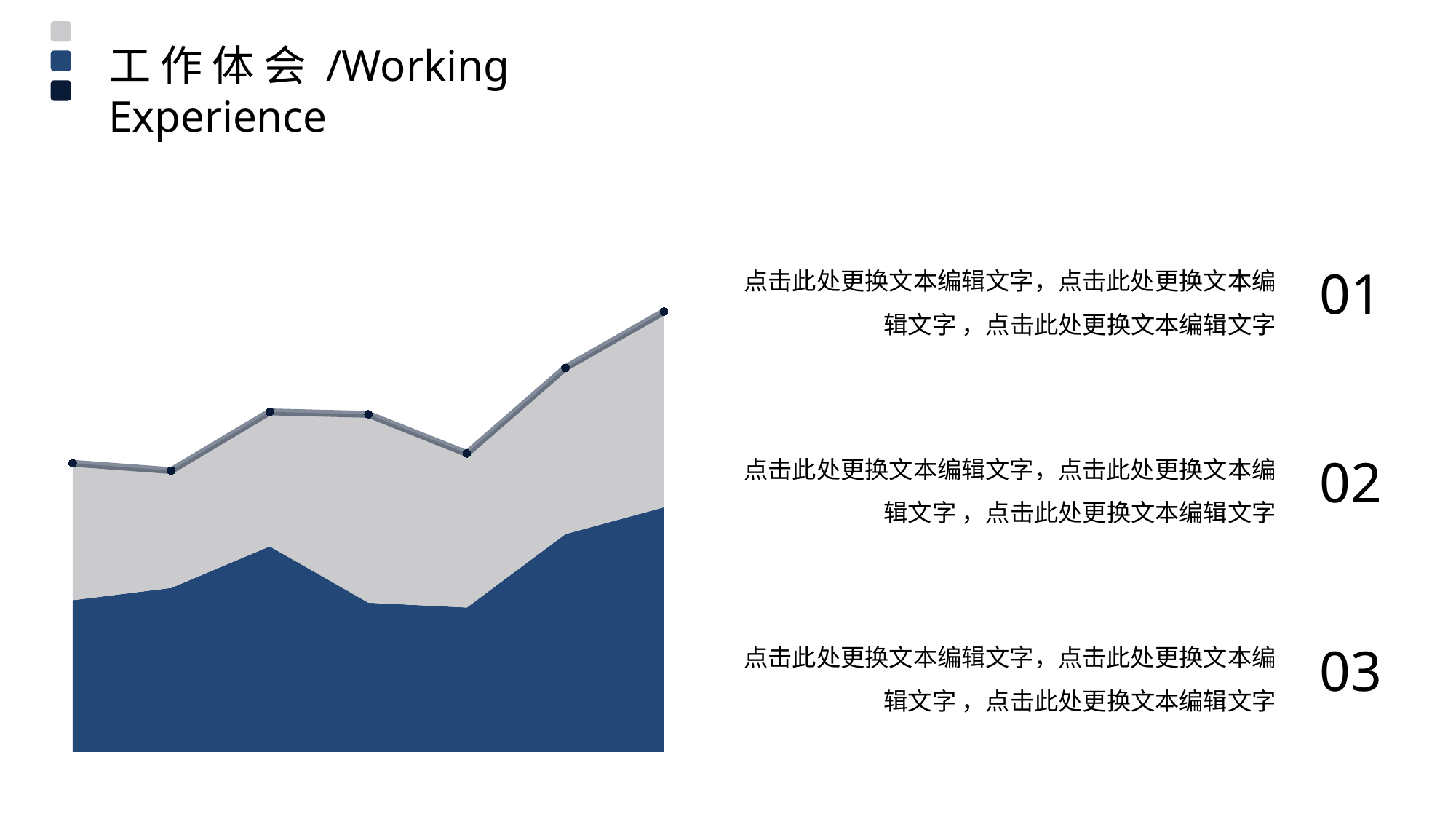
What colour is the upper area of the chart? grey What colour is the lower area of the chart? dark blue Which is higher on the upper line, the first point or the last point? the last point What kind of chart is shown on the left of the slide? area chart Which point on the upper line is the highest? the last (rightmost) point How many data points are marked on the upper line of the chart? 7 Overall, do the values of the upper line rise or fall from left to right? rise